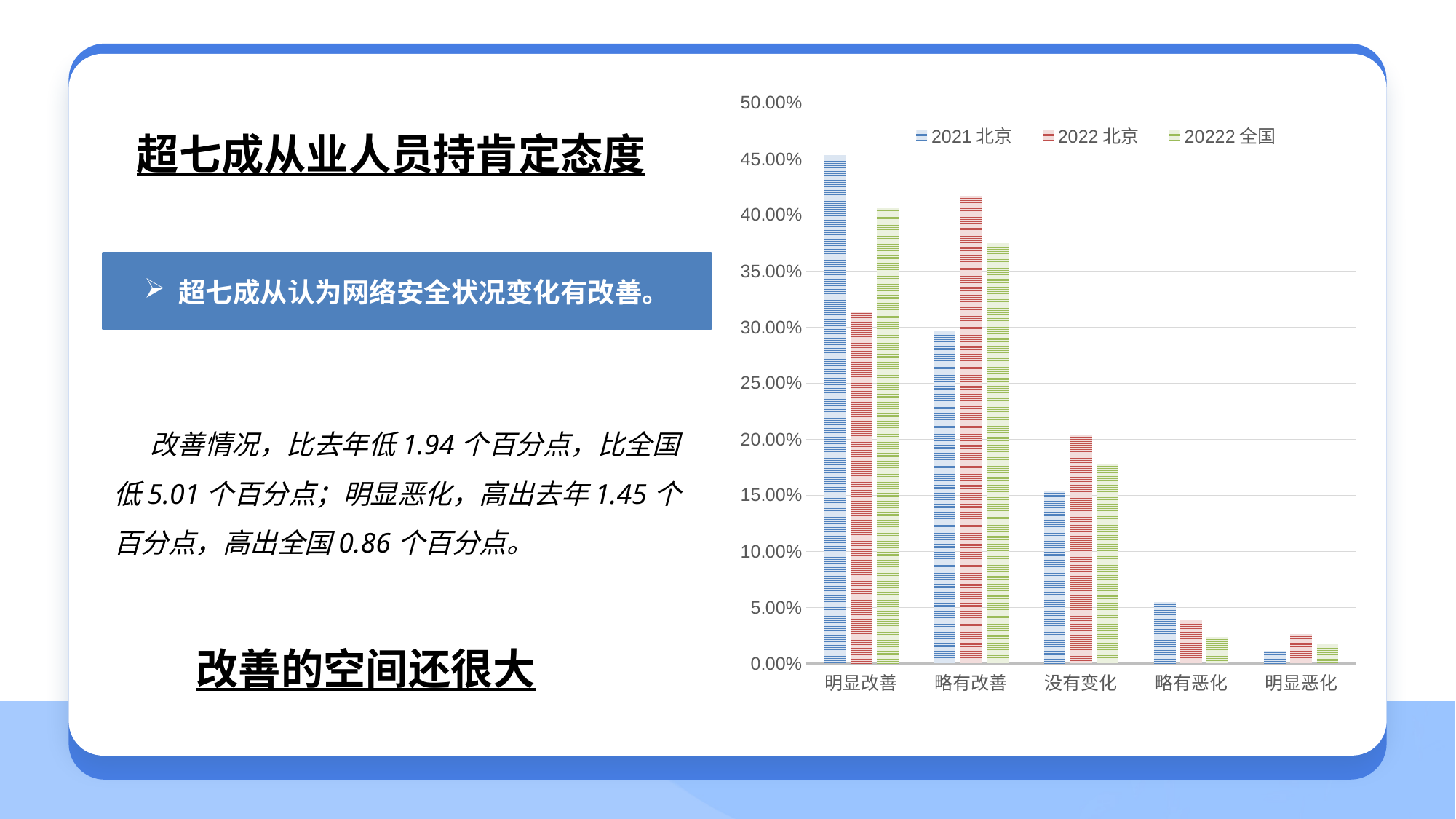
Which category has the lowest value for the 2021 北京 series? 明显恶化 Which category has the highest value for the 2021 北京 series? 明显改善 For the category 没有变化, which series has the larger value: 2022 北京 or 2021 北京? 2022 北京 Do the values for the 2022 北京 series rise or fall from 略有改善 to 明显恶化 along the x axis? fall Which category has the highest value for the 2022 北京 series? 略有改善 What kind of chart is shown on the slide? bar chart Is the value for 2021 北京 in the category 明显改善 greater or less than 40.00%? greater How many categories are shown on the x axis of the chart? 5 Is the value for 2022 北京 in the category 略有恶化 greater or less than 5.00%? less How many series does the chart legend list? 3 For the category 明显改善, which series has the larger value: 2021 北京 or 2022 北京? 2021 北京 What is the label of the third entry in the chart legend? 20222 全国